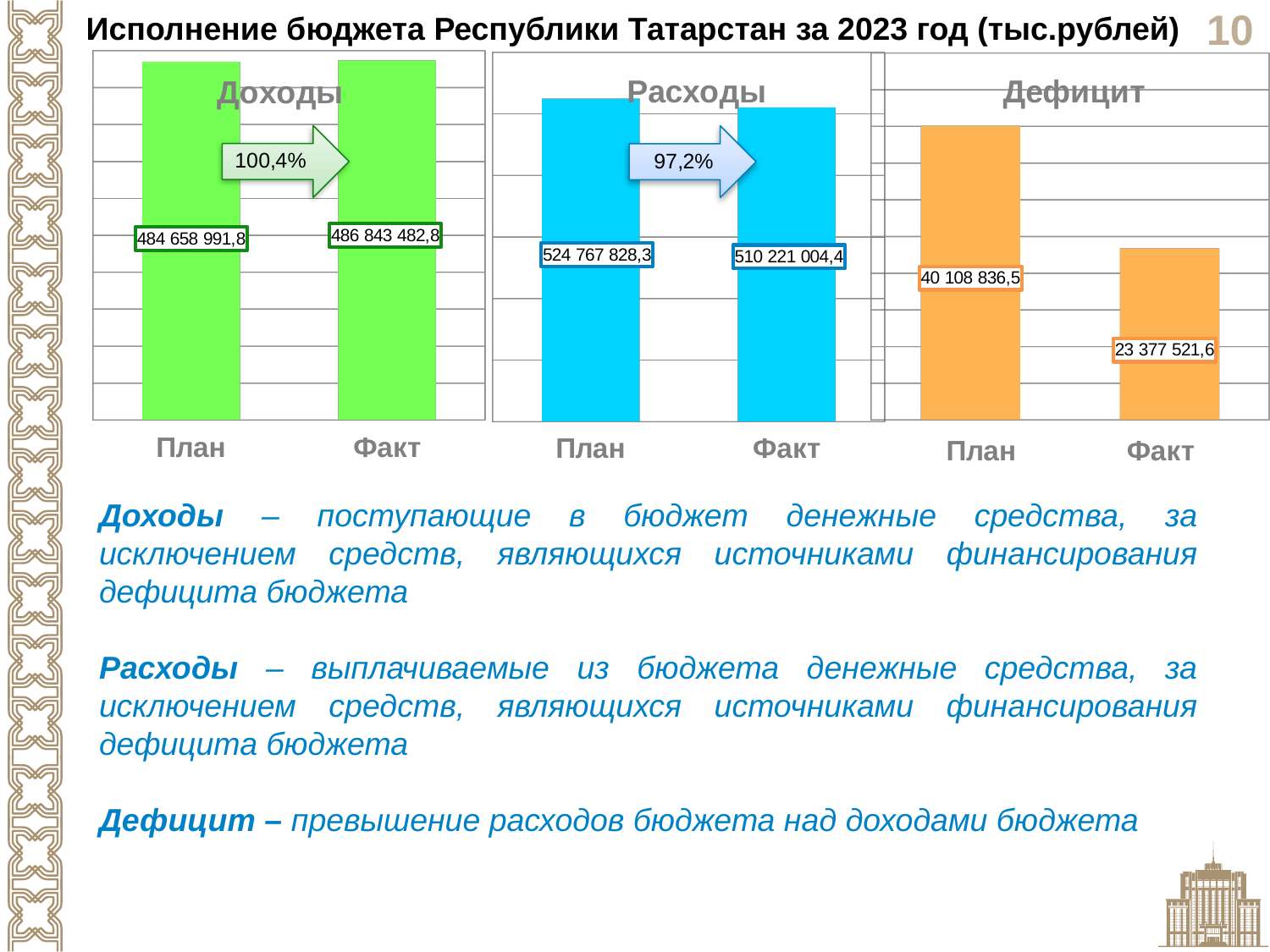
In the Дефицит chart, what is the difference between План and Факт? 16 731 314,9 In the Расходы chart, what is the value for Факт? 510 221 004,4 What type of chart is the Дефицит chart? bar chart In the Доходы chart, what is the value for План? 484 658 991,8 In the Расходы chart, what is the value for План? 524 767 828,3 In the Дефицит chart, which category has the higher value, План or Факт? План In the Доходы chart, by how much does Факт exceed План? 2 184 491,0 What percentage is shown on the arrow in the Расходы chart? 97,2% In the Дефицит chart, what is the value for Факт? 23 377 521,6 In the Расходы chart, by how much does План exceed Факт? 14 546 823,9 In the Доходы chart, what is the value for Факт? 486 843 482,8 In the Расходы chart, which category has the lower value? Факт